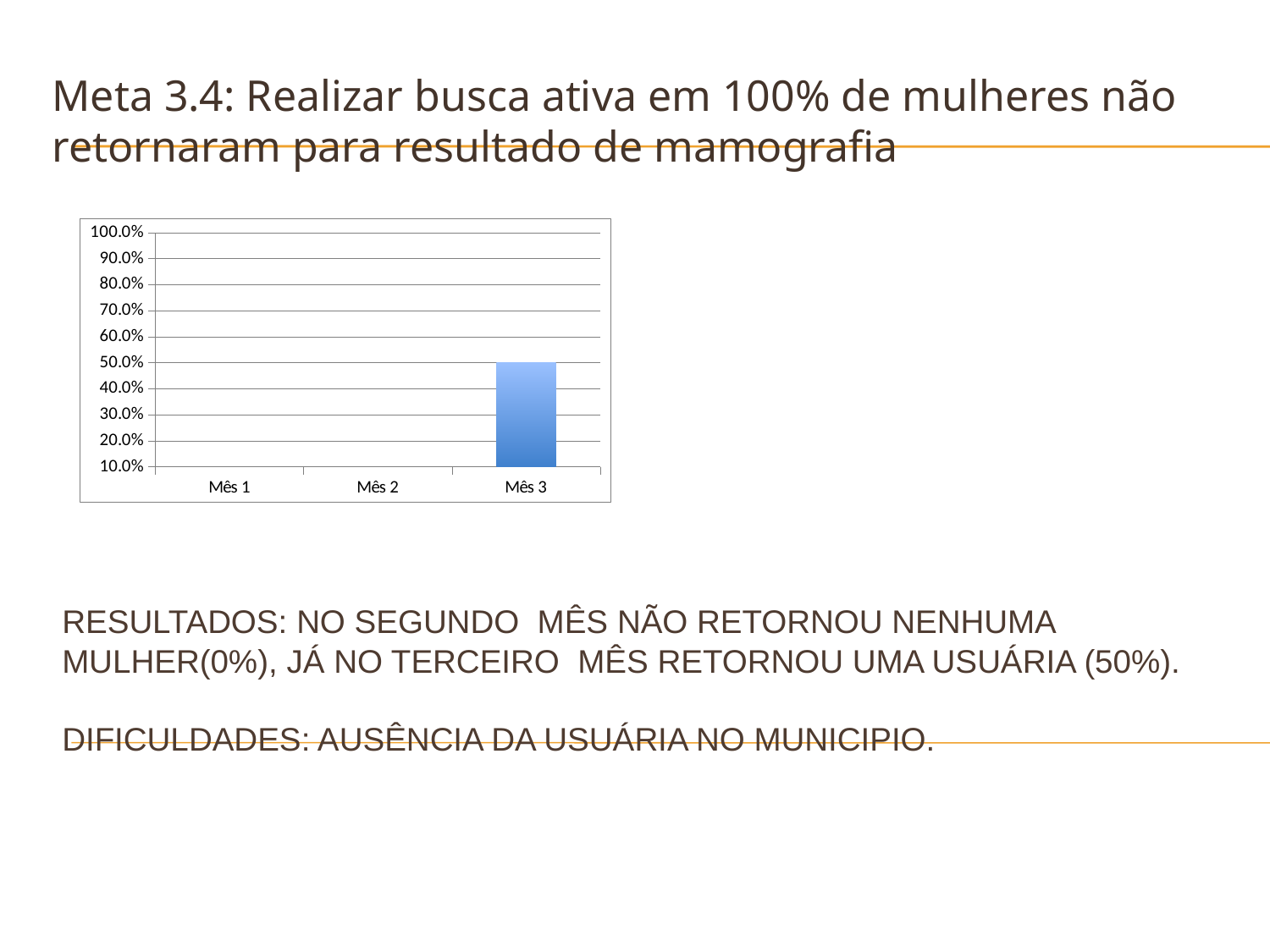
What is the value for Mês 3 in the chart? 50.0% Which categories in the chart have no visible bar? Mês 1 and Mês 2 What is the label of the third category on the x axis? Mês 3 Which category has the highest value in the chart? Mês 3 How many categories are shown on the x axis of the chart? 3 What is the highest value shown on the chart's vertical axis? 100.0% Which is larger, the value for Mês 2 or the value for Mês 3? Mês 3 Is the value for Mês 3 greater or less than 40.0%? greater What kind of chart is shown on the slide? Bar chart Is the value for Mês 3 greater or less than 60.0%? less Do the values rise or fall from Mês 2 to Mês 3? Rise